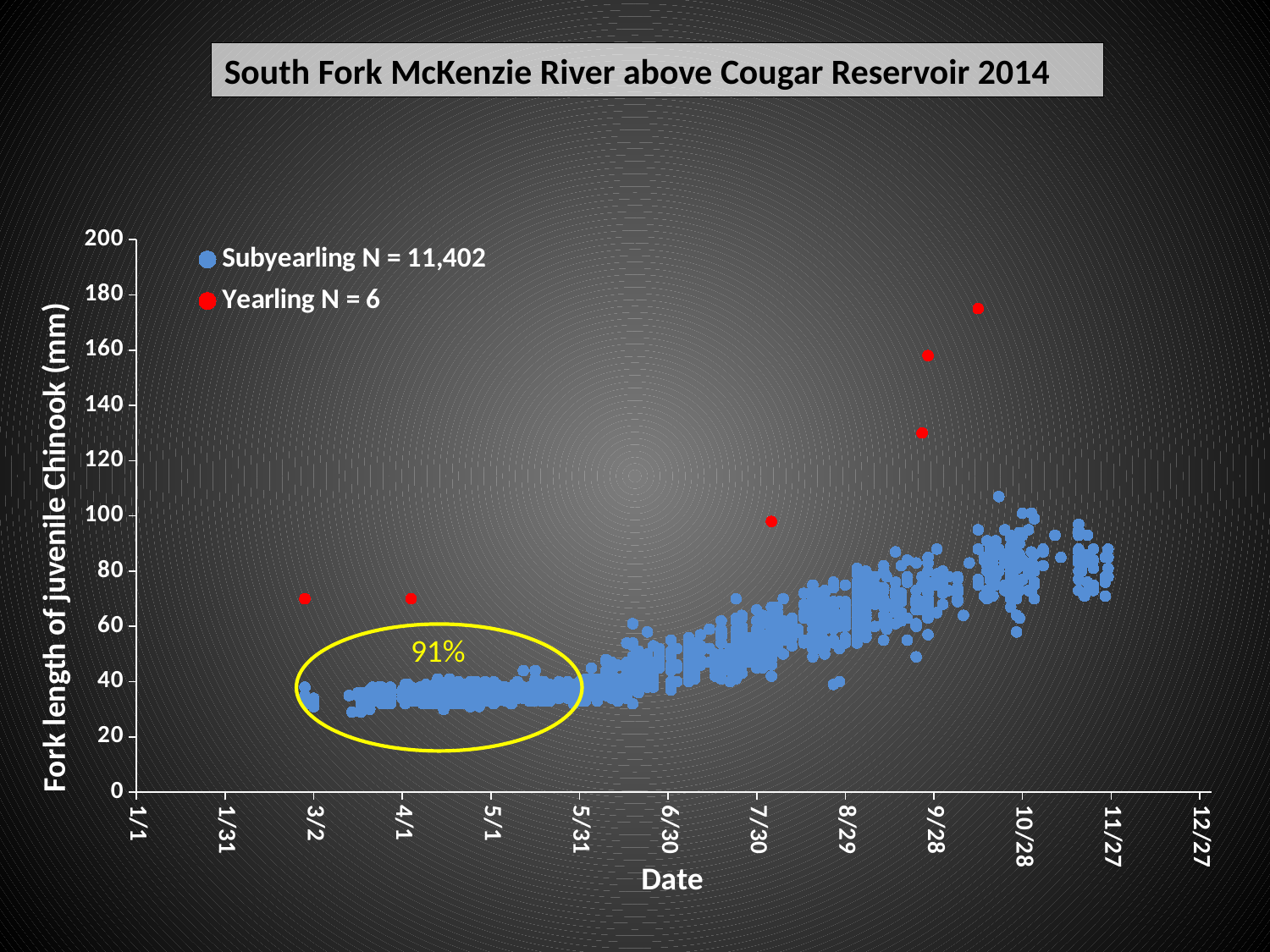
How many series does the legend list? 2 What kind of chart is shown on the slide? scatter plot Do the Subyearling fork lengths rise or fall as the date moves from 5/31 to 11/27? rise What is the title of the chart? South Fork McKenzie River above Cougar Reservoir 2014 Is the Yearling point near 3/2 greater or less than 80 mm? less What is the maximum value shown on the y axis? 200 How many Yearling points are plotted on the chart? 6 Is the highest Yearling point greater or less than 160 mm? greater What is the sample size (N) for the Subyearling series? 11,402 Which series contains the point with the greatest fork length, Subyearling or Yearling? Yearling What is the sample size (N) for the Yearling series? 6 What is the label of the y axis? Fork length of juvenile Chinook (mm)